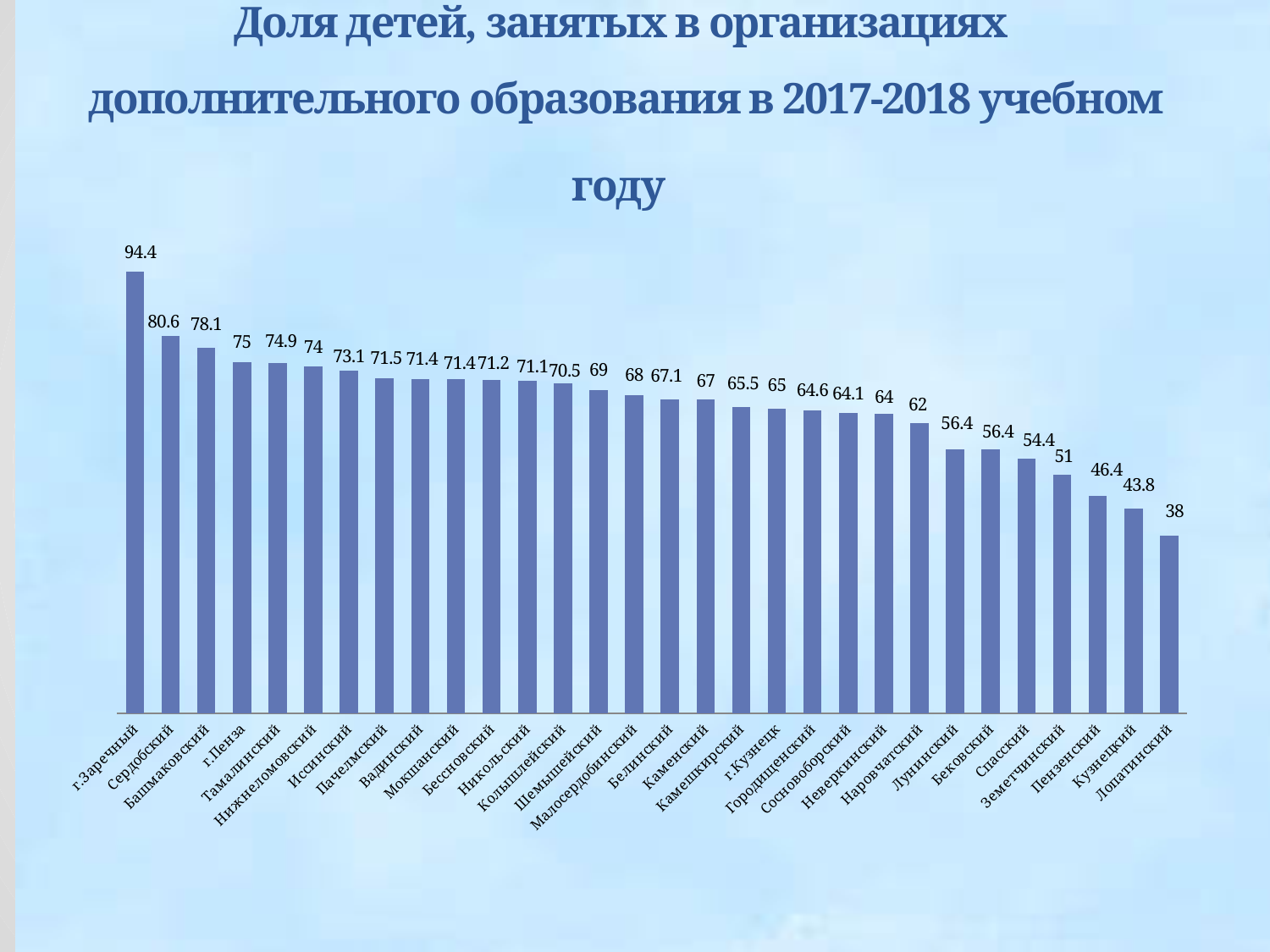
What is the value for г.Пенза? 75 What kind of chart is shown on the slide? Bar chart Which is larger, the value for Пензенский or the value for Кузнецкий? Пензенский What is the difference between the values for г.Заречный and Лопатинский? 56.4 Do the values rise or fall from left to right along the x axis? Fall Which category has the highest value? г.Заречный How many categories are shown on the chart? 30 What is the value for г.Заречный? 94.4 What is the value for Наровчатский? 62 What is the difference between the values for Сердобский and Башмаковский? 2.5 What is the value for Лопатинский? 38 Which category has the lowest value? Лопатинский